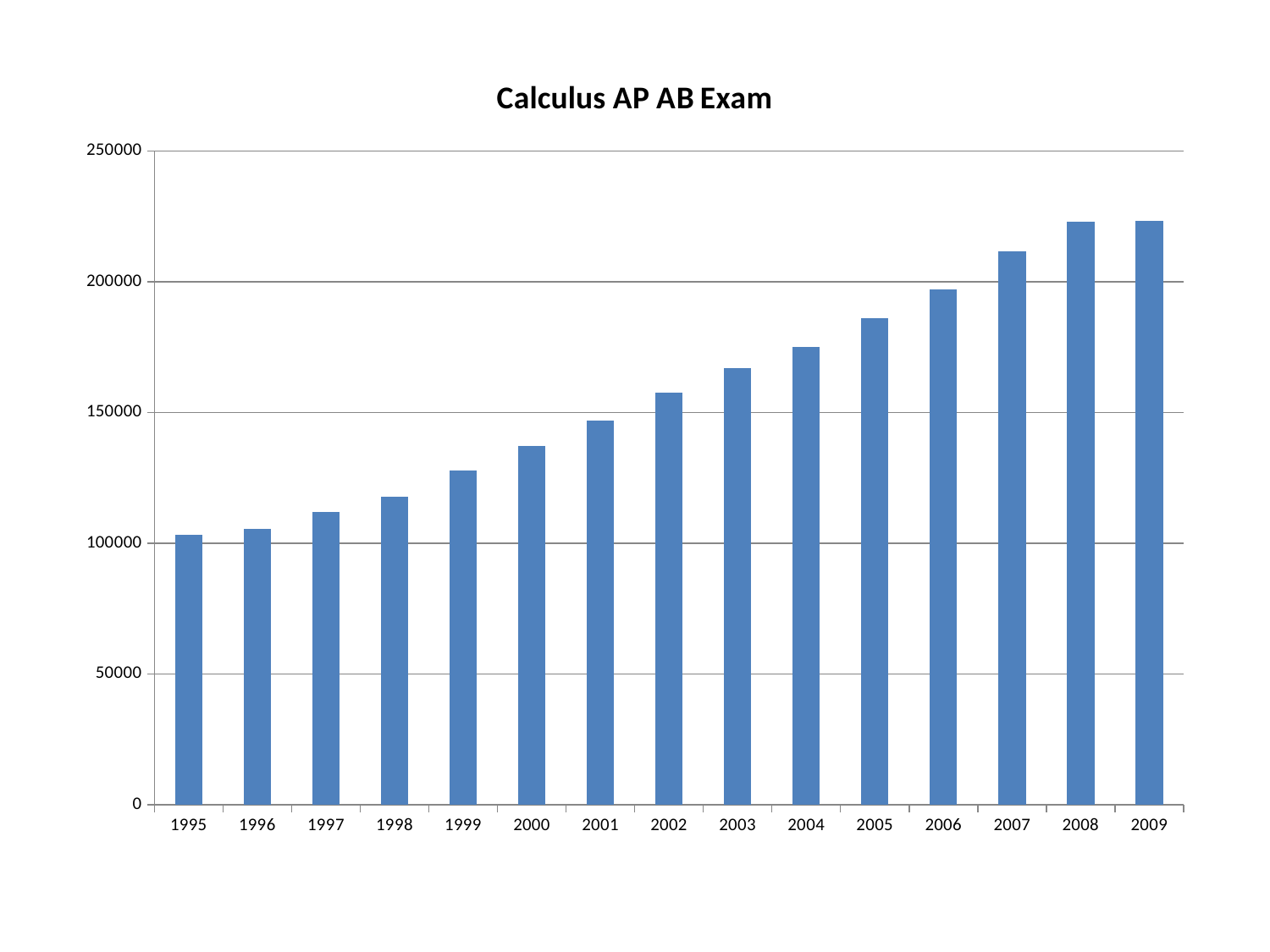
Is the value for 1998 greater or less than 150000? less How many years are shown on the x axis of the chart? 15 Do the values generally rise or fall from 1995 to 2009? rise Is the value for 2003 greater or less than 150000? greater Is the value for 2001 greater or less than 150000? less What kind of chart is shown on the slide? bar chart Which is larger, the value for 2000 or the value for 2005? 2005 What is the title of the chart? Calculus AP AB Exam Which is larger, the value for 1997 or the value for 2002? 2002